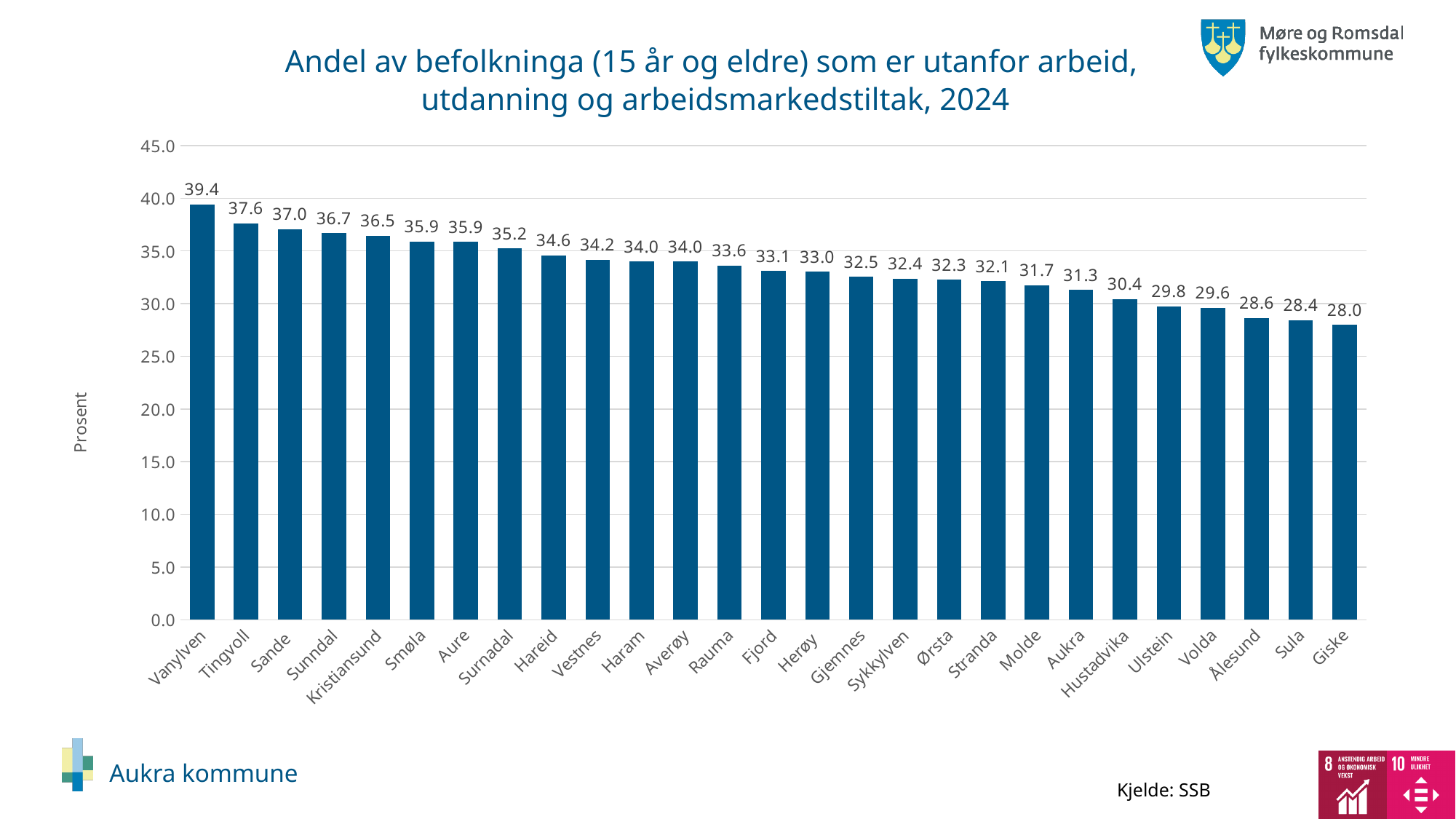
What kind of chart is shown on the slide? bar chart Which municipality has the highest value? Vanylven What is the difference between the values for Tingvoll and Aukra? 6.3 What is the value for Kristiansund? 36.5 How many municipalities are shown on the chart? 27 What is the value for Aukra? 31.3 What is the difference between the values for Vanylven and Giske? 11.4 Is the value for Hustadvika greater or less than 35.0? less Which municipality has the lowest value? Giske What is the value for Molde? 31.7 Which has a larger value, Sunndal or Ulstein? Sunndal Do the values rise or fall from left to right along the x axis? fall